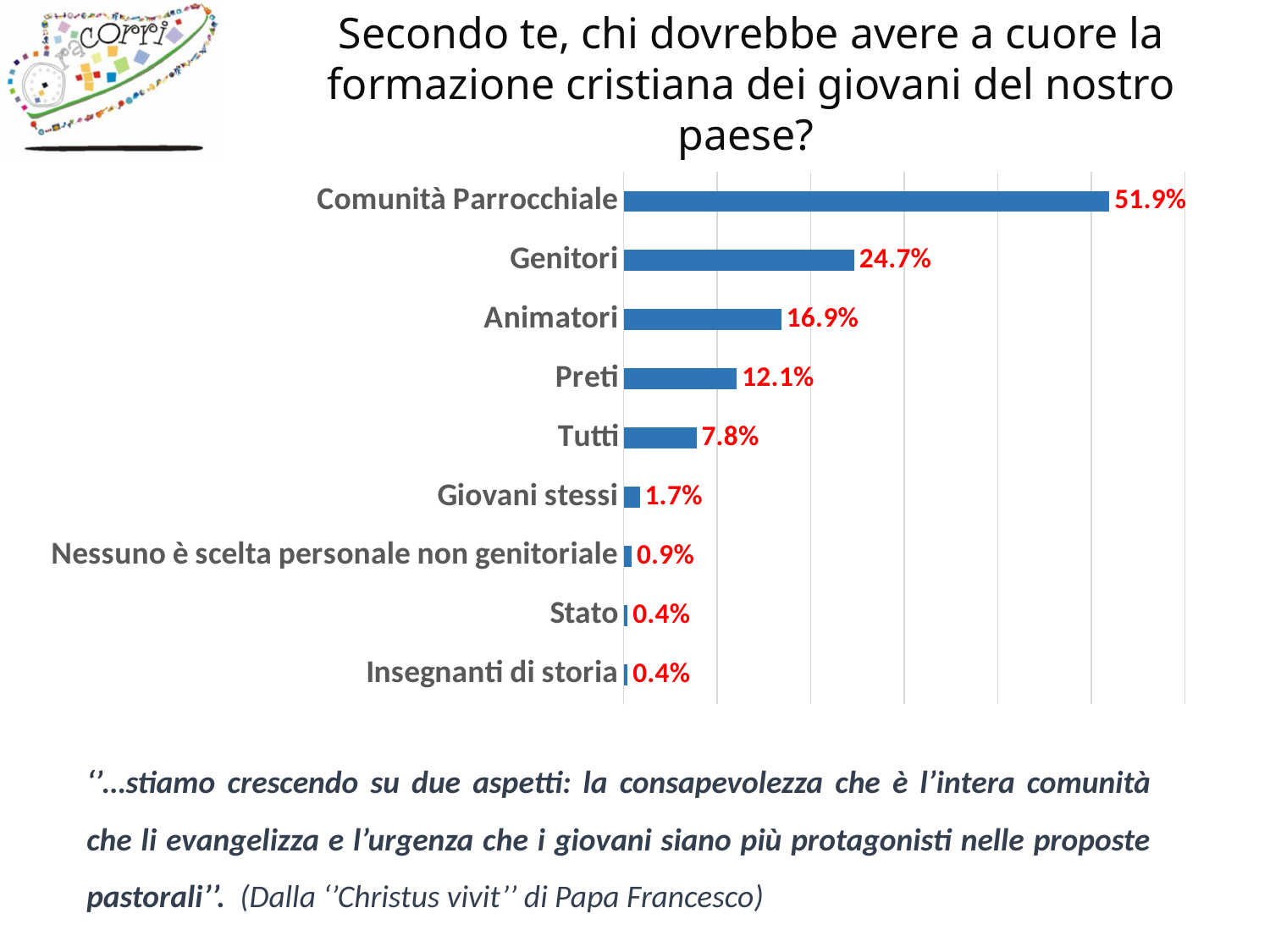
What is the difference between the values for Animatori and Preti? 4.8% What is the value for Genitori? 24.7% Which is larger, the value for Animatori or the value for Tutti? Animatori Which category has the highest value? Comunità Parrocchiale What is the value for Preti? 12.1% How many categories are shown in the chart? 9 Which two categories share the lowest value of 0.4%? Stato and Insegnanti di storia What kind of chart is shown on the slide? Bar chart What is the difference between the values for Comunità Parrocchiale and Genitori? 27.2% What is the value for Comunità Parrocchiale? 51.9% What is the value for Giovani stessi? 1.7% What is the value for Nessuno è scelta personale non genitoriale? 0.9%